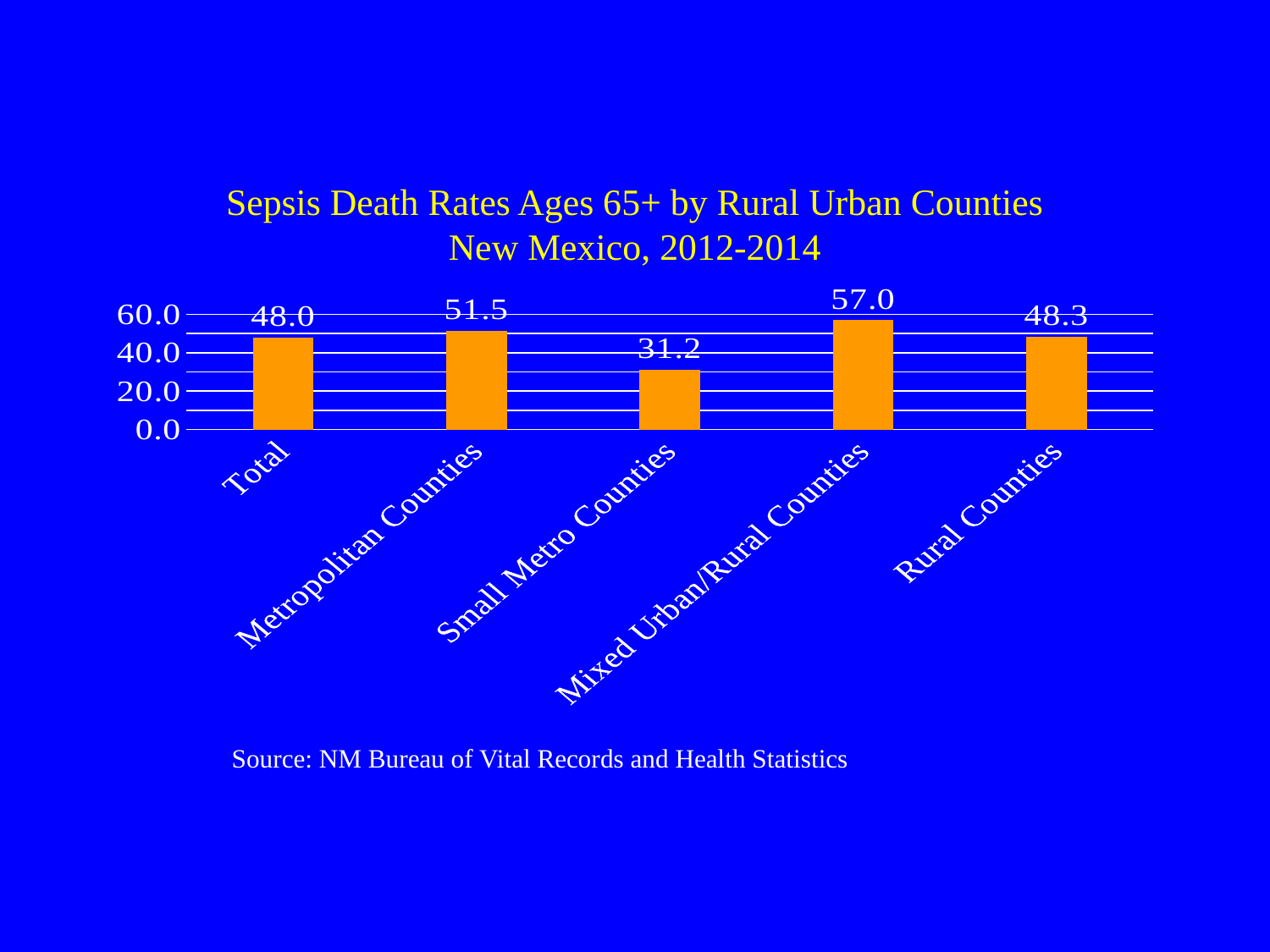
What is the difference between the rates for Metropolitan Counties and Rural Counties? 3.2 What is the value shown for Rural Counties? 48.3 Which category has the lowest sepsis death rate? Small Metro Counties What is the title of the chart? Sepsis Death Rates Ages 65+ by Rural Urban Counties New Mexico, 2012-2014 What is the value shown for the Total category? 48.0 What kind of chart is shown on the slide? Bar chart What is the sepsis death rate for Small Metro Counties? 31.2 How many categories are shown on the x axis? 5 Which category has the highest sepsis death rate? Mixed Urban/Rural Counties What is the difference between the rates for Mixed Urban/Rural Counties and Small Metro Counties? 25.8 What is the sepsis death rate for Metropolitan Counties? 51.5 Which is larger, the rate for Metropolitan Counties or the rate for Small Metro Counties? Metropolitan Counties